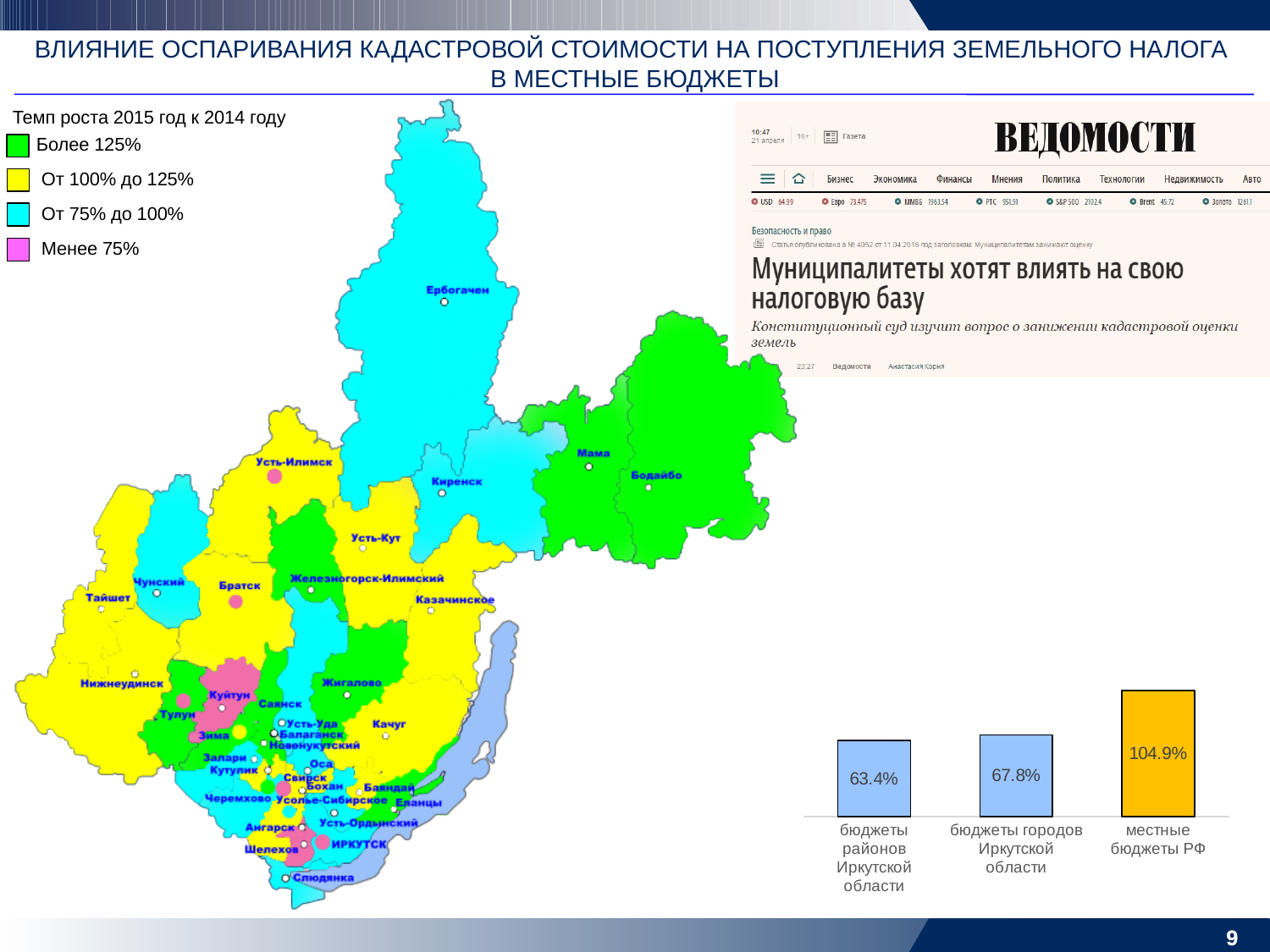
In the bar chart at the bottom right, which category has the highest value? местные бюджеты РФ In the bar chart at the bottom right, what is the value for бюджеты районов Иркутской области? 63.4% In the bar chart at the bottom right, which is larger: бюджеты городов Иркутской области or бюджеты районов Иркутской области? бюджеты городов Иркутской области What kind of chart is shown at the bottom right of the slide? bar chart In the bar chart at the bottom right, what is the difference between бюджеты городов Иркутской области and бюджеты районов Иркутской области? 4.4% How many categories are shown in the bar chart at the bottom right? 3 In the bar chart at the bottom right, what colour is the bar for местные бюджеты РФ? orange In the bar chart at the bottom right, what is the difference between местные бюджеты РФ and бюджеты городов Иркутской области? 37.1% In the bar chart at the bottom right, what is the value for бюджеты городов Иркутской области? 67.8% In the bar chart at the bottom right, what is the value for местные бюджеты РФ? 104.9% In the bar chart at the bottom right, what is the difference between местные бюджеты РФ and бюджеты районов Иркутской области? 41.5% In the bar chart at the bottom right, which category has the lowest value? бюджеты районов Иркутской области